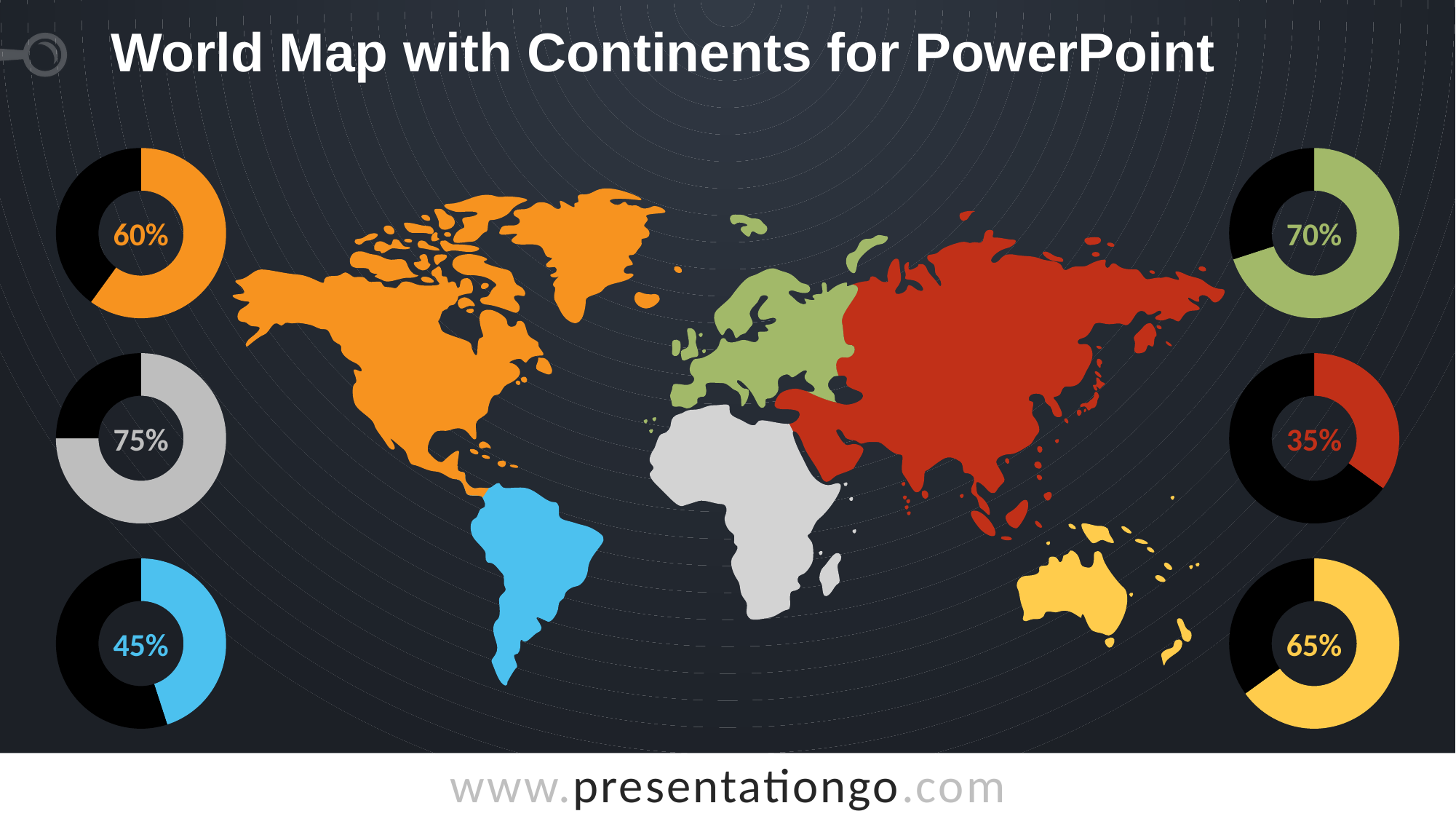
What value is shown in the top-right donut chart (green)? 70% Which donut chart shows the lowest percentage? The red middle-right chart (35%) Which donut chart shows the highest percentage? The grey middle-left chart (75%) What is the difference between the value in the grey donut chart and the value in the red donut chart? 40% What value is shown in the bottom-left donut chart (blue)? 45% What value is shown in the bottom-right donut chart (yellow)? 65% Which is larger, the value in the green donut chart or the value in the yellow donut chart? The green donut chart (70%) What value is shown in the top-left donut chart (orange)? 60% How many donut charts are on the slide? 6 What value is shown in the middle-left donut chart (grey)? 75% What kind of charts are used on the slide to show the percentages? Donut (pie) charts What value is shown in the middle-right donut chart (red)? 35%